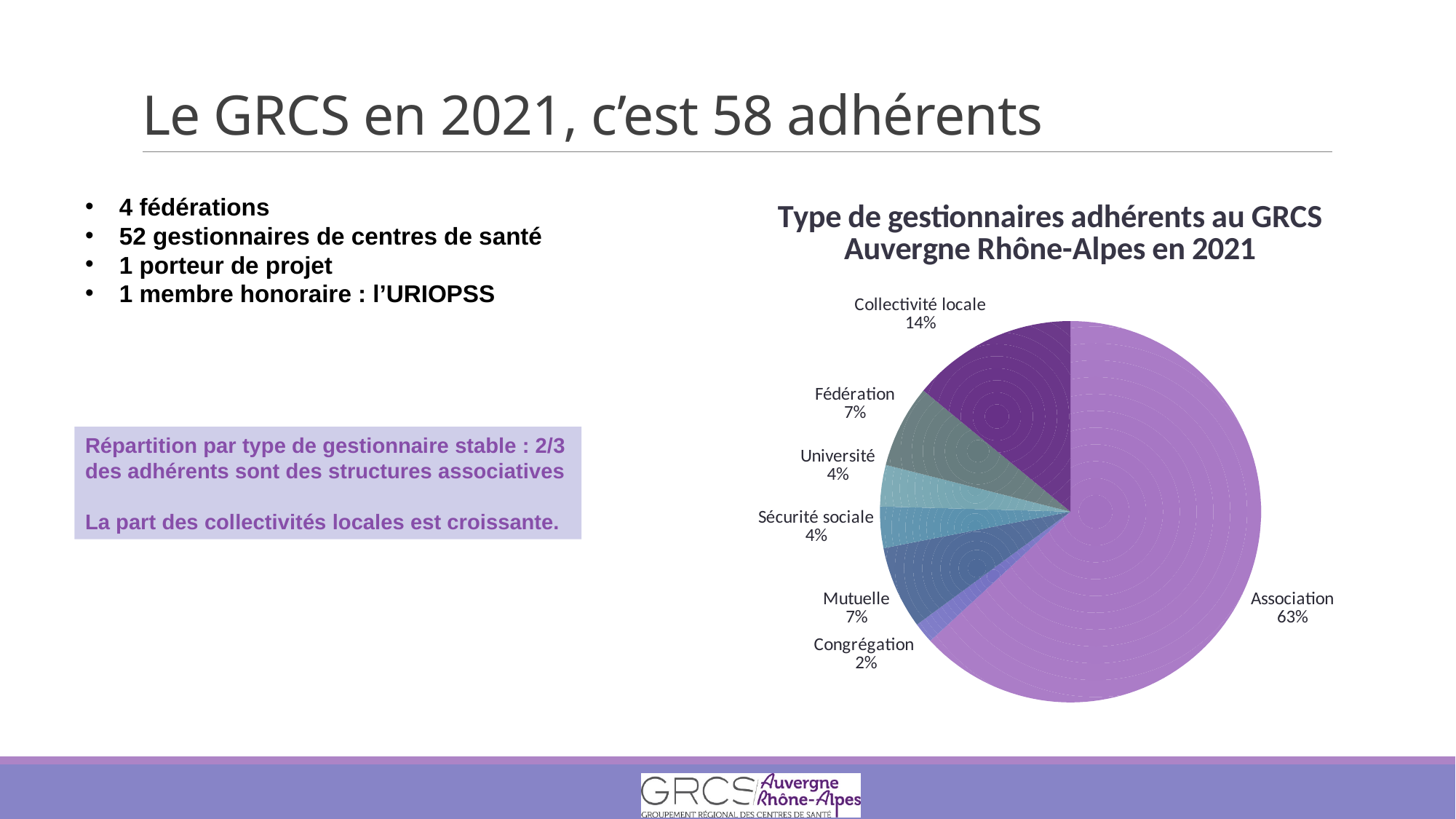
How many categories are shown in the pie chart? 7 What is the value shown for Mutuelle? 7% What share of the pie does Association represent? 63% What is the title of the chart? Type de gestionnaires adhérents au GRCS Auvergne Rhône-Alpes en 2021 What kind of chart is shown on the slide? Pie chart Which category has the smallest slice of the pie? Congrégation Which is larger, the share for Fédération or the share for Université? Fédération What is the difference in percentage points between Association and Collectivité locale? 49 What is the combined share of Sécurité sociale and Université? 8% What is the value shown for Collectivité locale? 14% Which category has the largest slice of the pie? Association What is the value shown for Congrégation? 2%